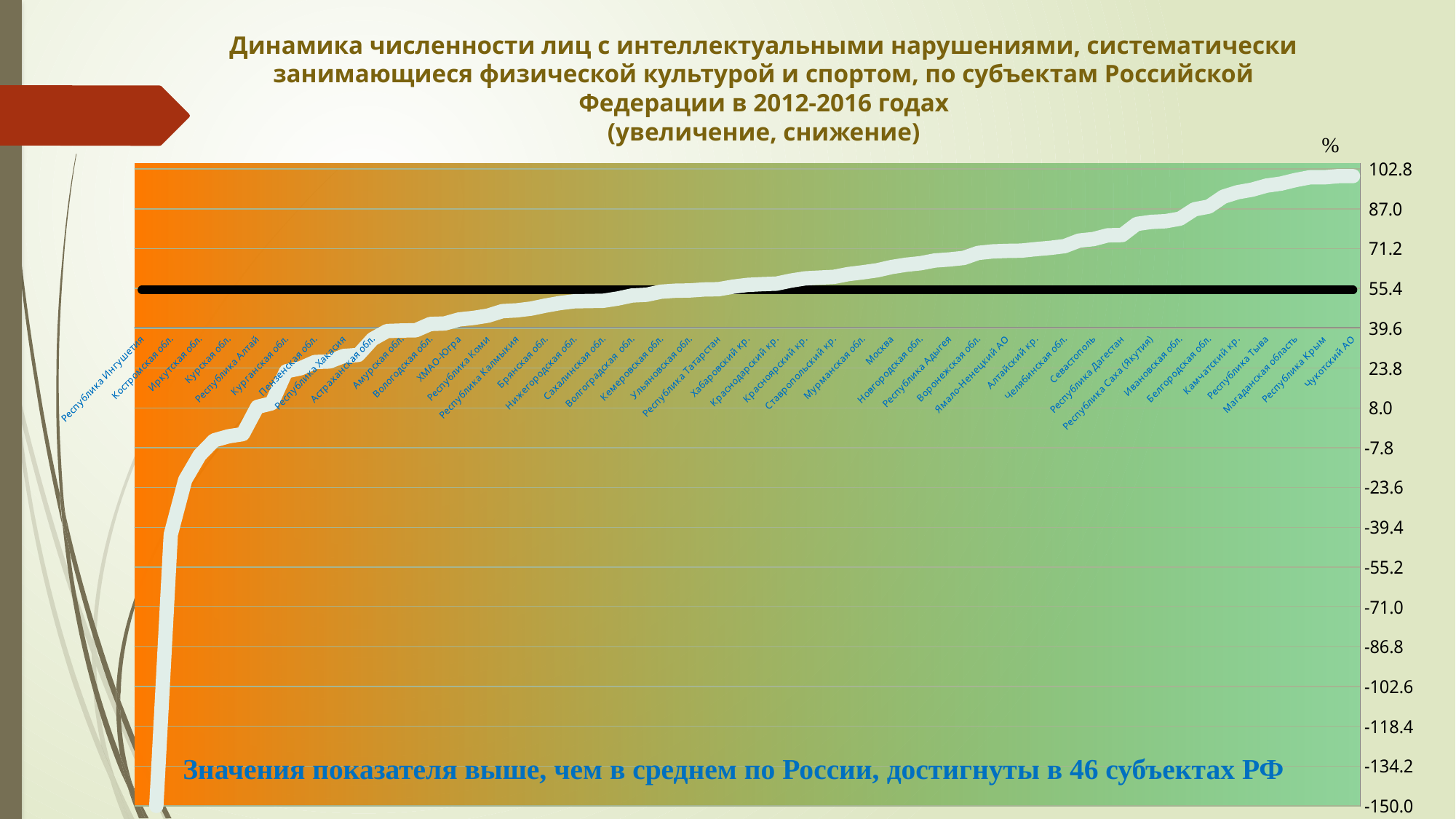
According to the text on the chart, in how many subjects of the Russian Federation is the indicator above the Russian average? 46 Is the value for Чукотский АО greater or less than 87.0? greater What unit is shown above the y axis of the chart? % Which has the higher value, Москва or Иркутская обл.? Москва Is the value for Иркутская обл. greater or less than -23.6? greater Is the value for Курская обл. greater or less than 8.0? less Which has the higher value, Чукотский АО or Республика Ингушетия? Чукотский АО Do the values of the white line rise or fall from left to right along the x axis? rise What kind of chart is shown on the slide? line chart